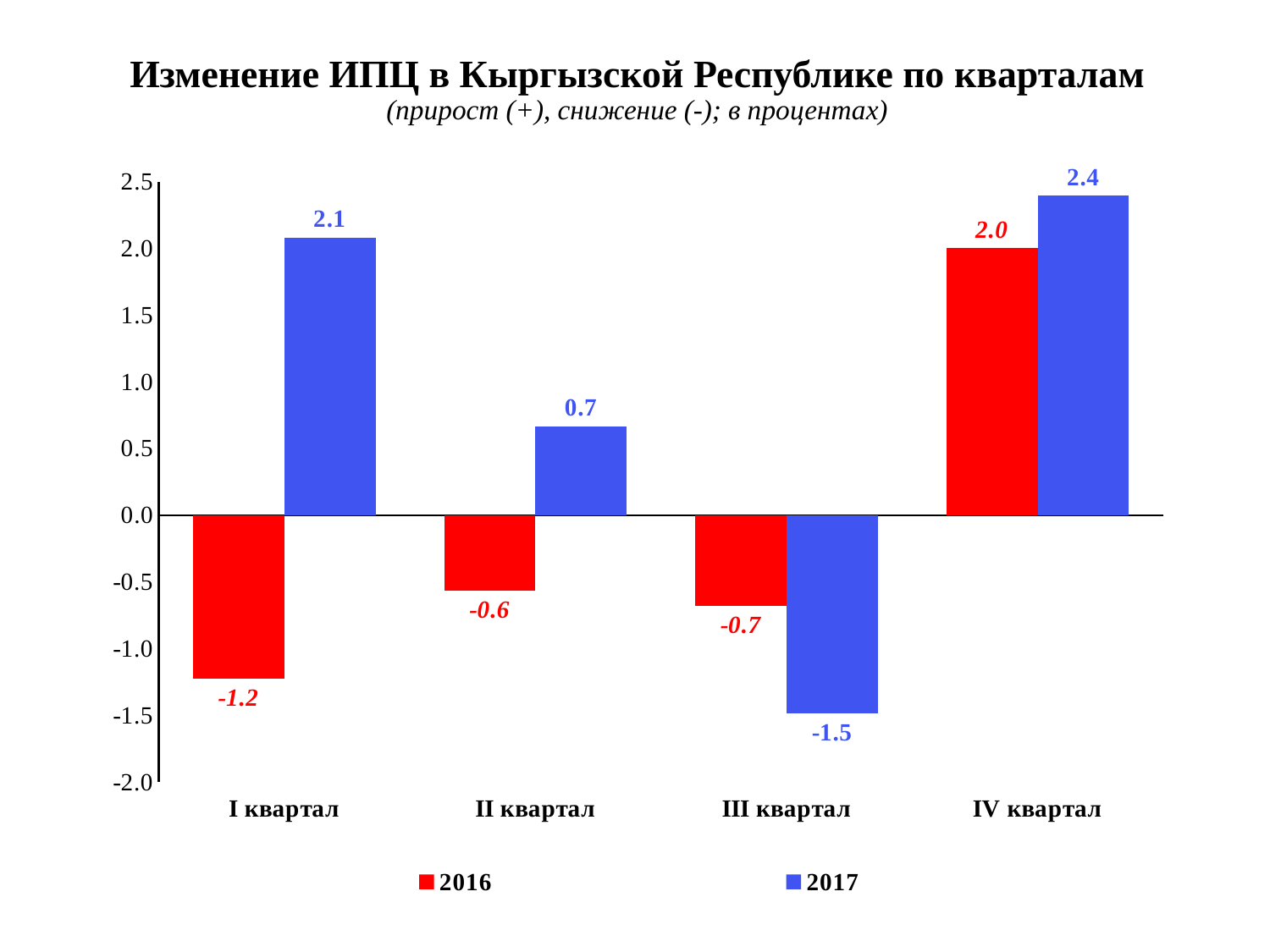
Which is larger in III квартал, the 2016 value or the 2017 value? 2016 How many quarters are shown on the x axis? 4 How many series does the legend list? 2 Which colour represents the 2017 series? Blue What is the value for 2016 in IV квартал? 2.0 In which quarter is the 2017 value highest? IV квартал What kind of chart is shown on the slide? Bar chart In which quarter is the 2016 value lowest? I квартал What is the difference between the 2017 and 2016 values in I квартал? 3.3 What is the value for 2017 in I квартал? 2.1 What is the value for 2017 in II квартал? 0.7 What is the value for 2016 in III квартал? -0.7